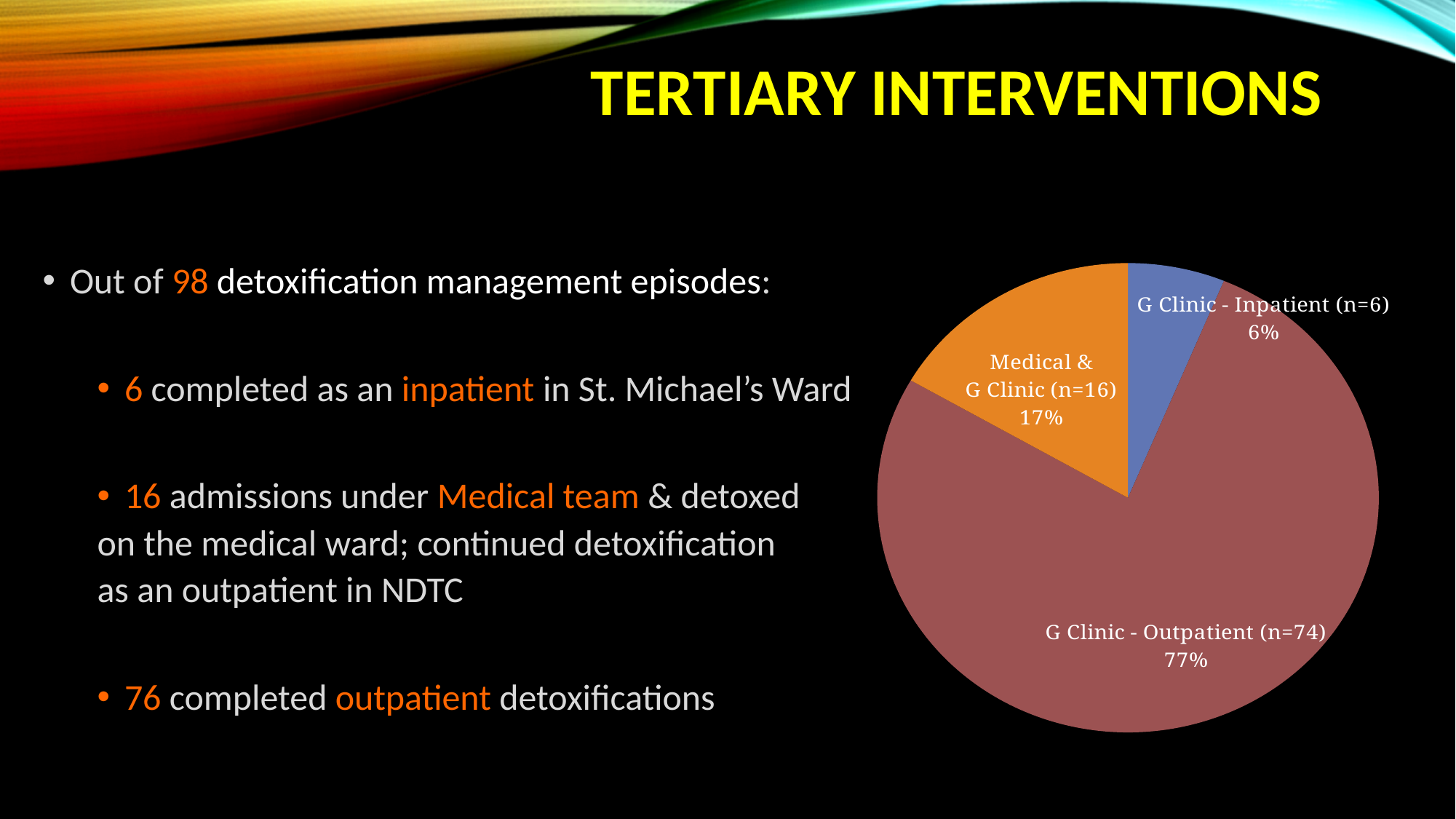
What percentage share does the G Clinic - Outpatient slice have? 77% What is the n value shown for G Clinic - Outpatient? n=74 Which slice of the pie chart is the smallest? G Clinic - Inpatient (n=6) What is the n value shown for Medical & G Clinic? n=16 What is the n value shown for G Clinic - Inpatient? n=6 What percentage share does the G Clinic - Inpatient slice have? 6% What percentage share does the Medical & G Clinic slice have? 17% Which is larger, the Medical & G Clinic slice or the G Clinic - Inpatient slice? Medical & G Clinic What colour is the G Clinic - Inpatient slice? blue Which slice of the pie chart is the largest? G Clinic - Outpatient (n=74) What kind of chart is shown on the slide? pie chart How many slices does the pie chart have? 3